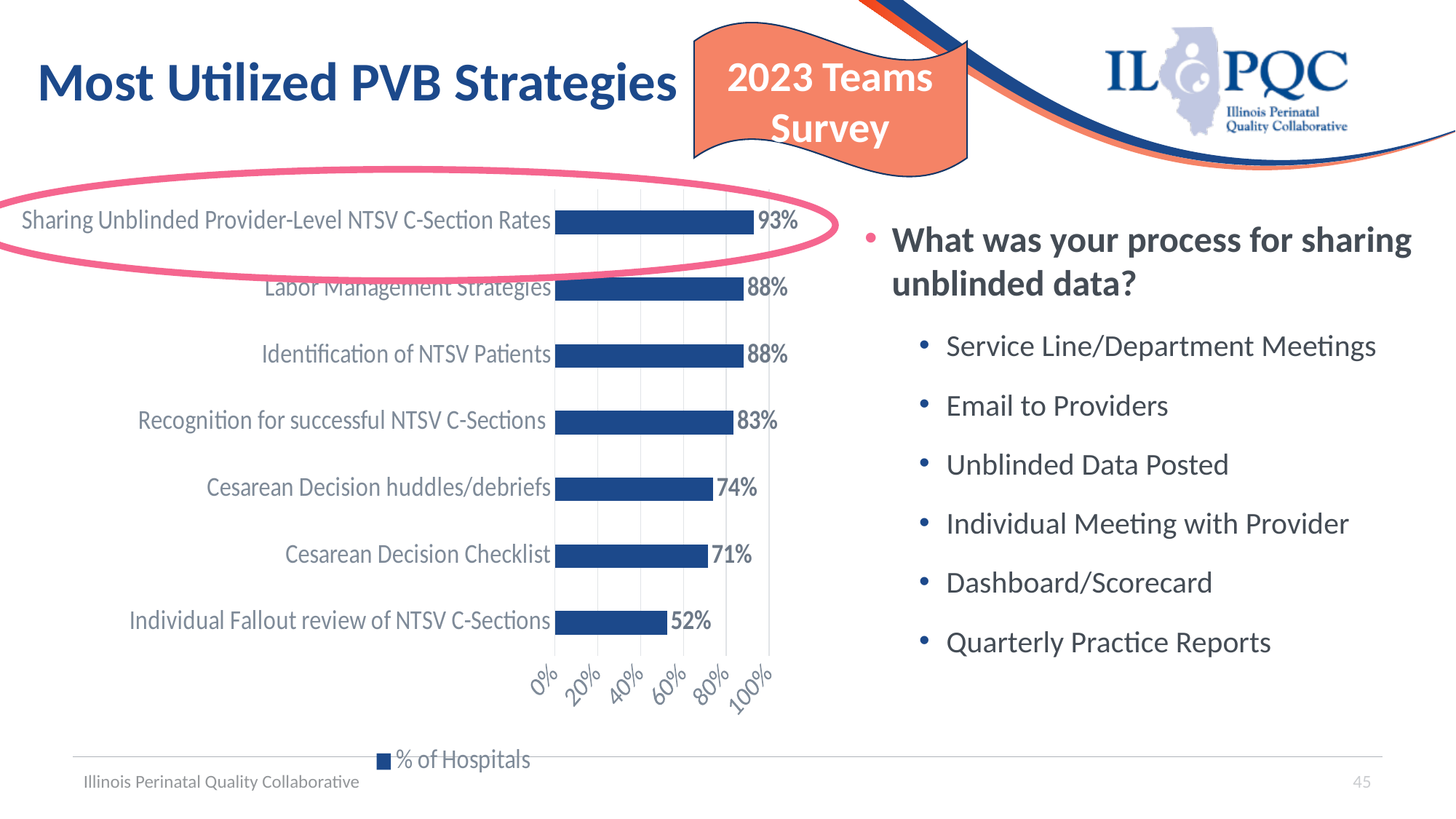
What is the legend entry for the series in the chart? % of Hospitals How many strategies are shown in the chart? 7 What is the difference between the values for Recognition for successful NTSV C-Sections and Cesarean Decision Checklist? 12% What is the value for Individual Fallout review of NTSV C-Sections? 52% Which is larger: the value for Labor Management Strategies or the value for Cesarean Decision huddles/debriefs? Labor Management Strategies Is the value for Cesarean Decision Checklist greater or less than 60%? greater Which strategy has the highest percentage of hospitals? Sharing Unblinded Provider-Level NTSV C-Section Rates What percentage of hospitals reported Sharing Unblinded Provider-Level NTSV C-Section Rates? 93% Which strategy has the lowest percentage of hospitals? Individual Fallout review of NTSV C-Sections What kind of chart is shown on the slide? Bar chart What is the value for Cesarean Decision huddles/debriefs? 74% How many series does the legend list? 1